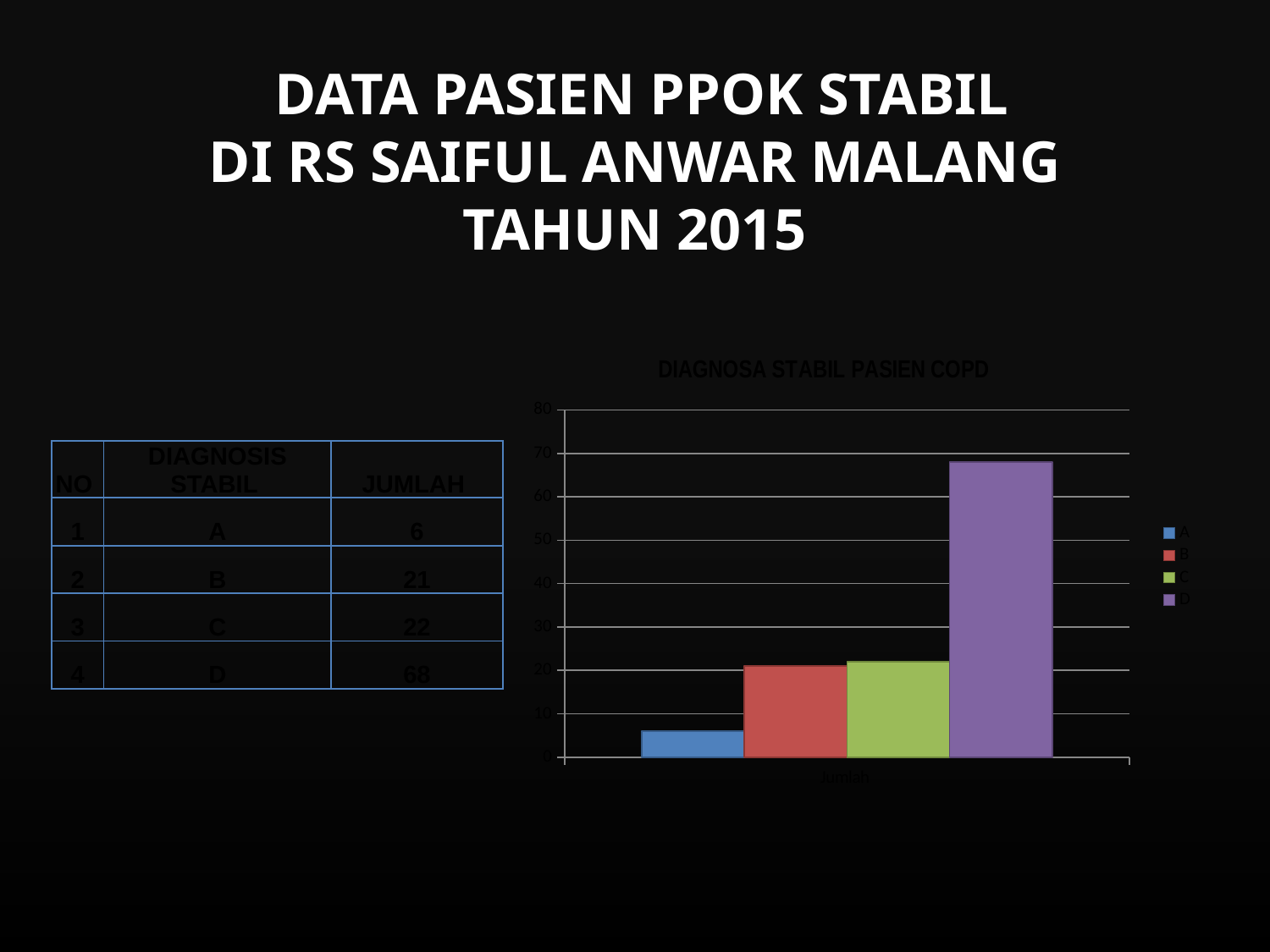
What is the value (Jumlah) for series B? 21 How many series does the chart legend list? 4 What is the title of the chart? DIAGNOSA STABIL PASIEN COPD Is the value for series A greater or less than 10? less What is the value (Jumlah) for series A? 6 Which is larger, the value for series D or the value for series C? D What is the value (Jumlah) for series D? 68 Which series has the highest value in the chart? D Is the value for series D greater or less than 60? greater What is the difference between the values for series D and series A? 62 What type of chart is shown on the slide? bar chart Which series has the lowest value in the chart? A